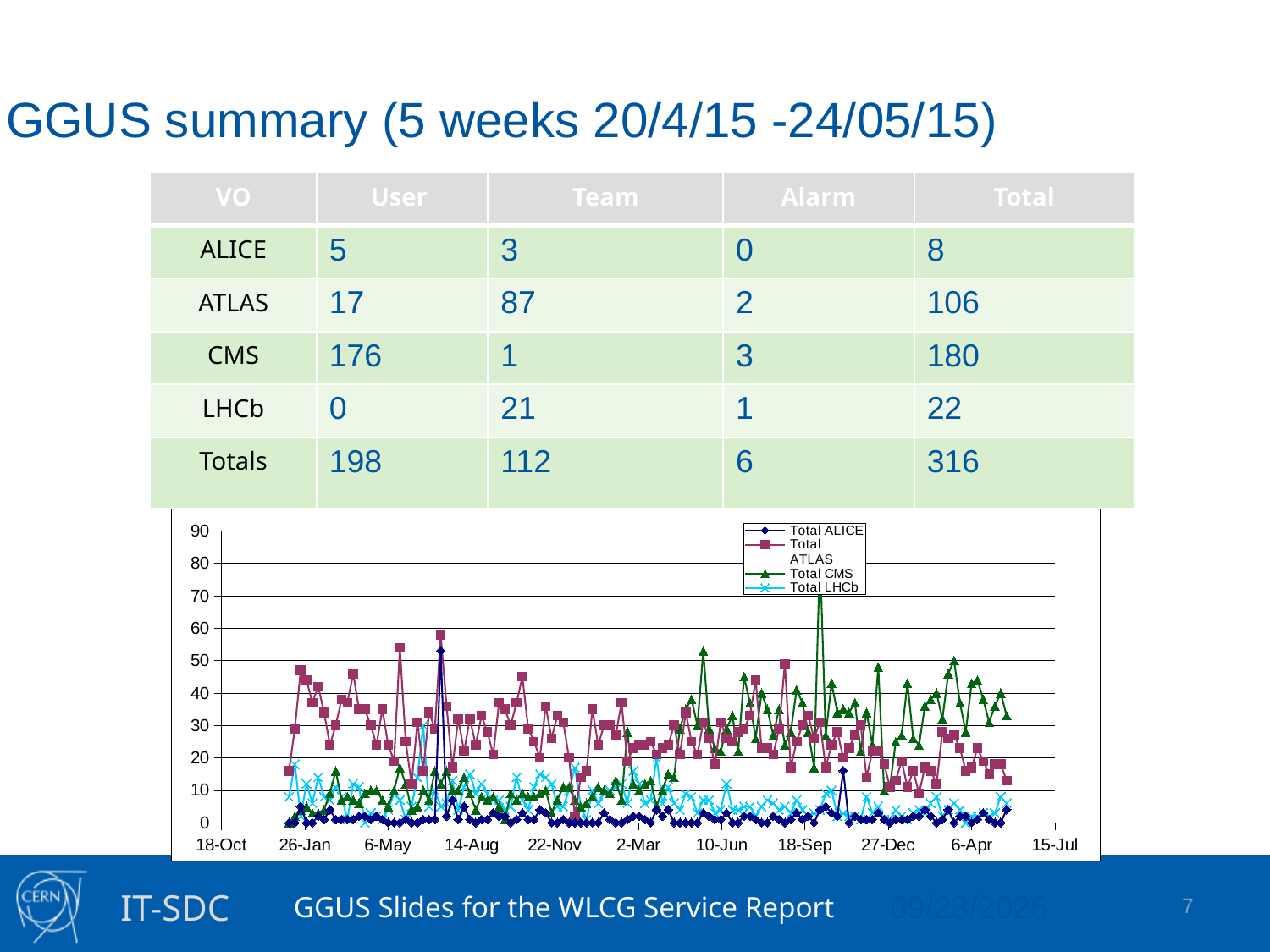
Does the Total ATLAS series generally rise or fall from the left of the chart to the right? fall Which series is drawn in green on the chart? Total CMS Is the highest peak of the Total ALICE series greater or less than 40? greater Which series has the higher peak on the chart, Total CMS or Total LHCb? Total CMS What kind of chart is shown on the slide? line chart Is the highest peak of the Total ATLAS series greater or less than 50? greater How many series does the chart's legend list? 4 Is the highest peak of the Total CMS series greater or less than 60? greater How many date labels are shown along the chart's x axis? 11 What is the highest value shown on the chart's vertical axis? 90 Which series reaches the highest peak on the chart? Total CMS